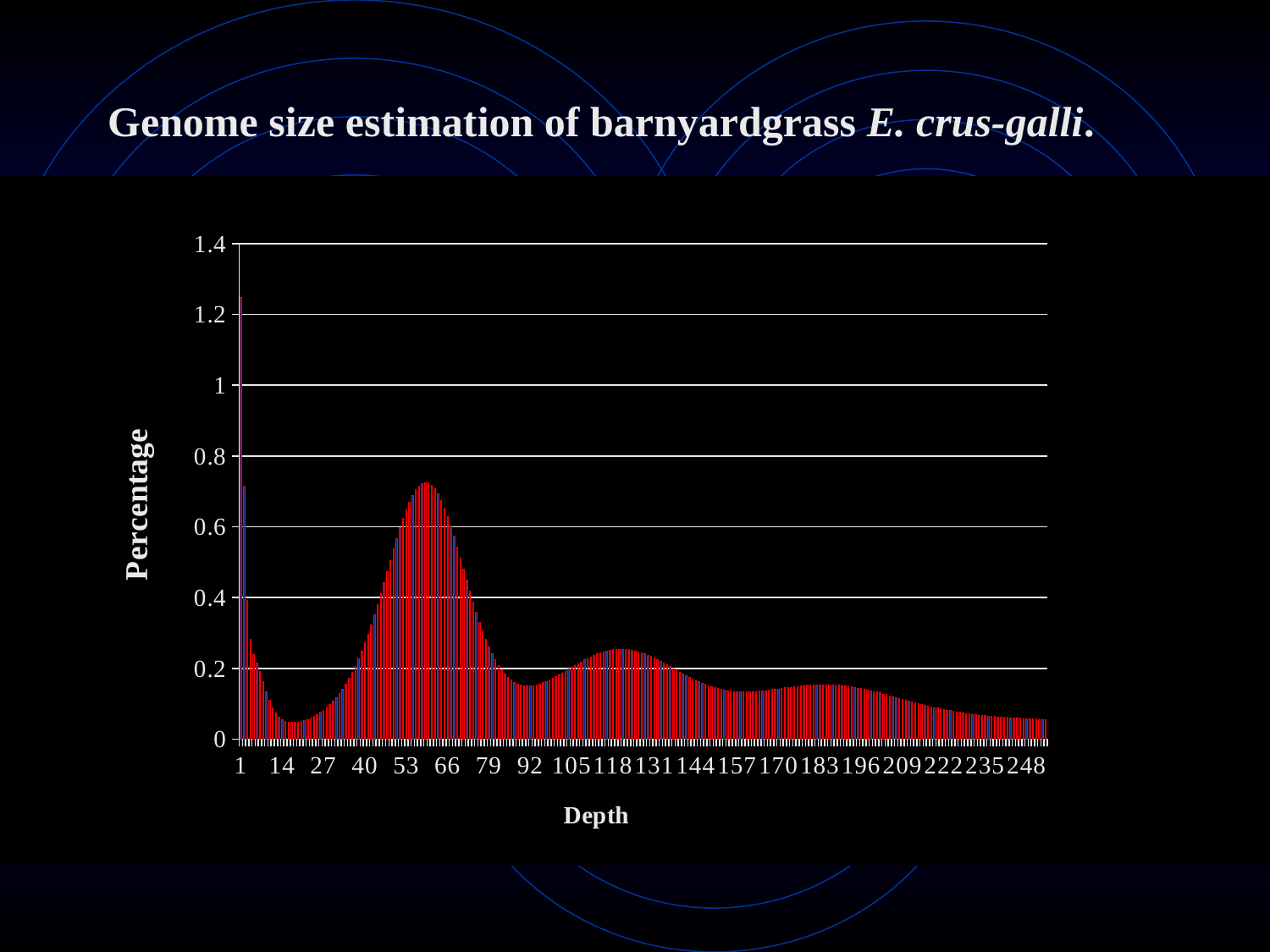
Do the percentages rise or fall as depth increases from 27 to 53? rise What kind of chart is shown on the slide? bar chart Is the percentage at depth 1 greater or less than 1? greater What is the title of the slide's chart? Genome size estimation of barnyardgrass E. crus-galli. Which depth has the larger percentage, 1 or 66? 1 Is the highest percentage in the peak around depth 53-66 greater or less than 0.8? less What are the x-axis and y-axis titles of the chart? Depth (x-axis) and Percentage (y-axis) Is the percentage at depth 248 greater or less than 0.2? less At which depth is the percentage highest? 1 Do the percentages rise or fall as depth increases from 196 to 248? fall Which depth has the larger percentage, 53 or 118? 53